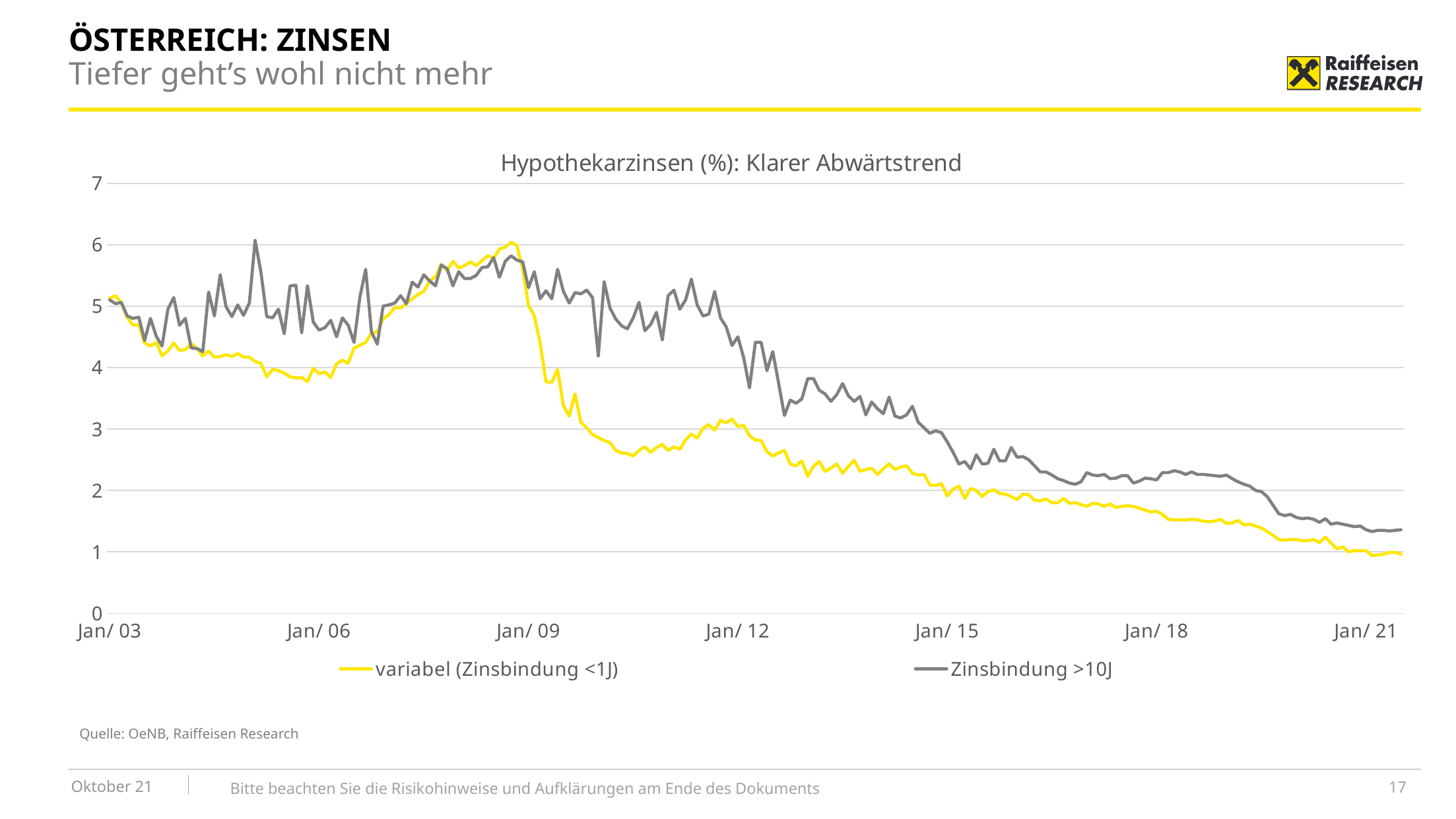
At Jan/ 12, which series has the higher value, 'variabel (Zinsbindung <1J)' or 'Zinsbindung >10J'? Zinsbindung >10J Is the value for 'Zinsbindung >10J' at Jan/ 18 greater or less than 3? less Is the value for 'variabel (Zinsbindung <1J)' at Jan/ 21 greater or less than 2? less What kind of chart is shown on the slide? line chart Is the value for 'Zinsbindung >10J' at Jan/ 21 greater or less than 2? less Do the values of the 'variabel (Zinsbindung <1J)' series rise or fall overall from Jan/ 09 to Jan/ 21? fall Do the values of the 'Zinsbindung >10J' series rise or fall overall from Jan/ 03 to Jan/ 21? fall What is the title of the chart? Hypothekarzinsen (%): Klarer Abwärtstrend How many series does the legend list? 2 What colour is the line for 'variabel (Zinsbindung <1J)'? yellow